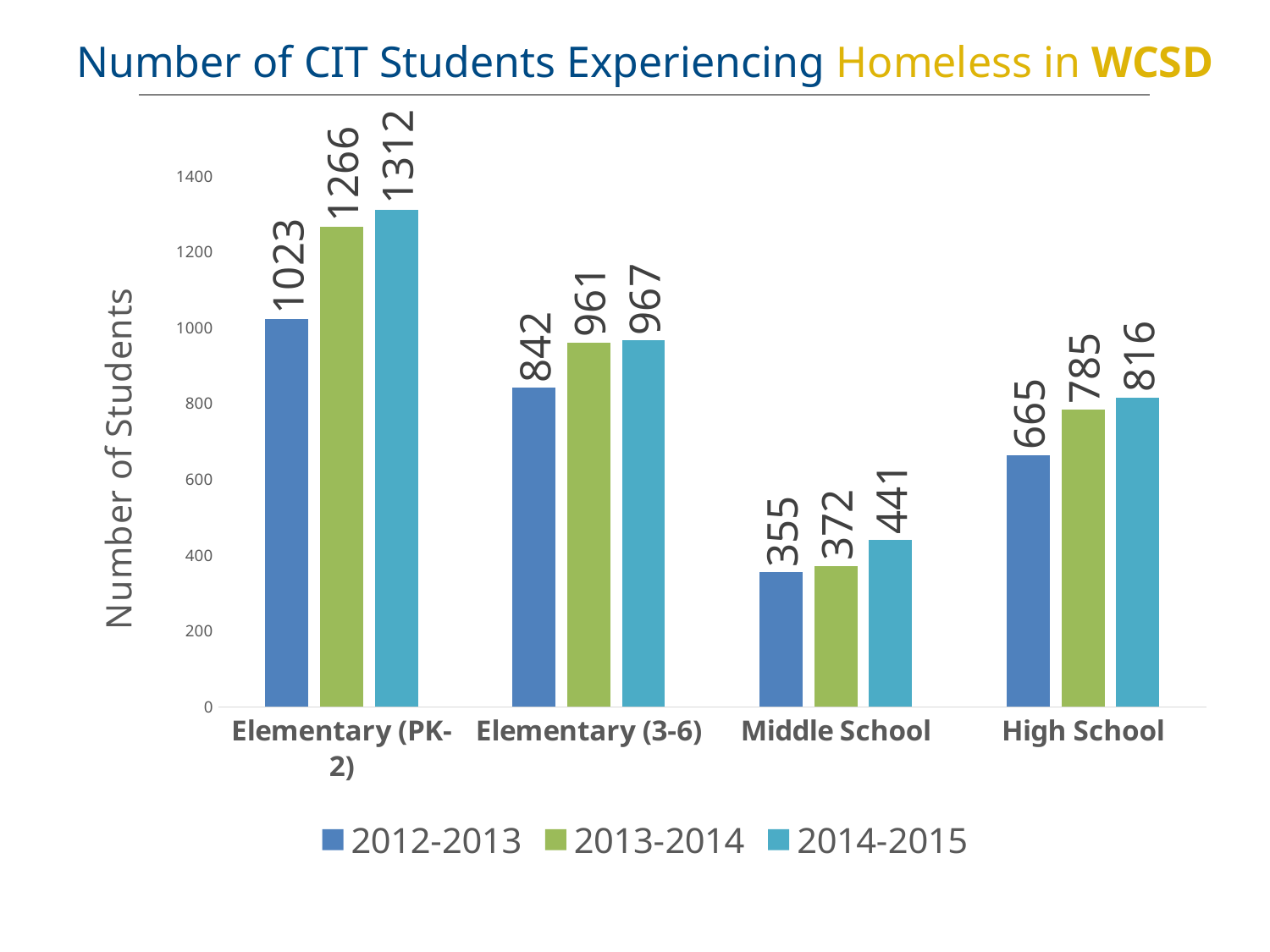
What is the label of the y axis? Number of Students How many series does the legend list? 3 What is the value for High School in the 2013-2014 series? 785 Which category has the highest value in the 2014-2015 series? Elementary (PK-2) Which category has the lowest value in the 2012-2013 series? Middle School What is the difference between the 2014-2015 and 2012-2013 values for Elementary (PK-2)? 289 Which is larger: the 2013-2014 value for Elementary (3-6) or the 2014-2015 value for High School? 2013-2014 value for Elementary (3-6) What is the value for Elementary (PK-2) in the 2014-2015 series? 1312 How many categories are shown on the x axis? 4 What kind of chart is shown on the slide? Bar chart What is the difference between the 2014-2015 and 2013-2014 values for Middle School? 69 What is the value for Middle School in the 2012-2013 series? 355